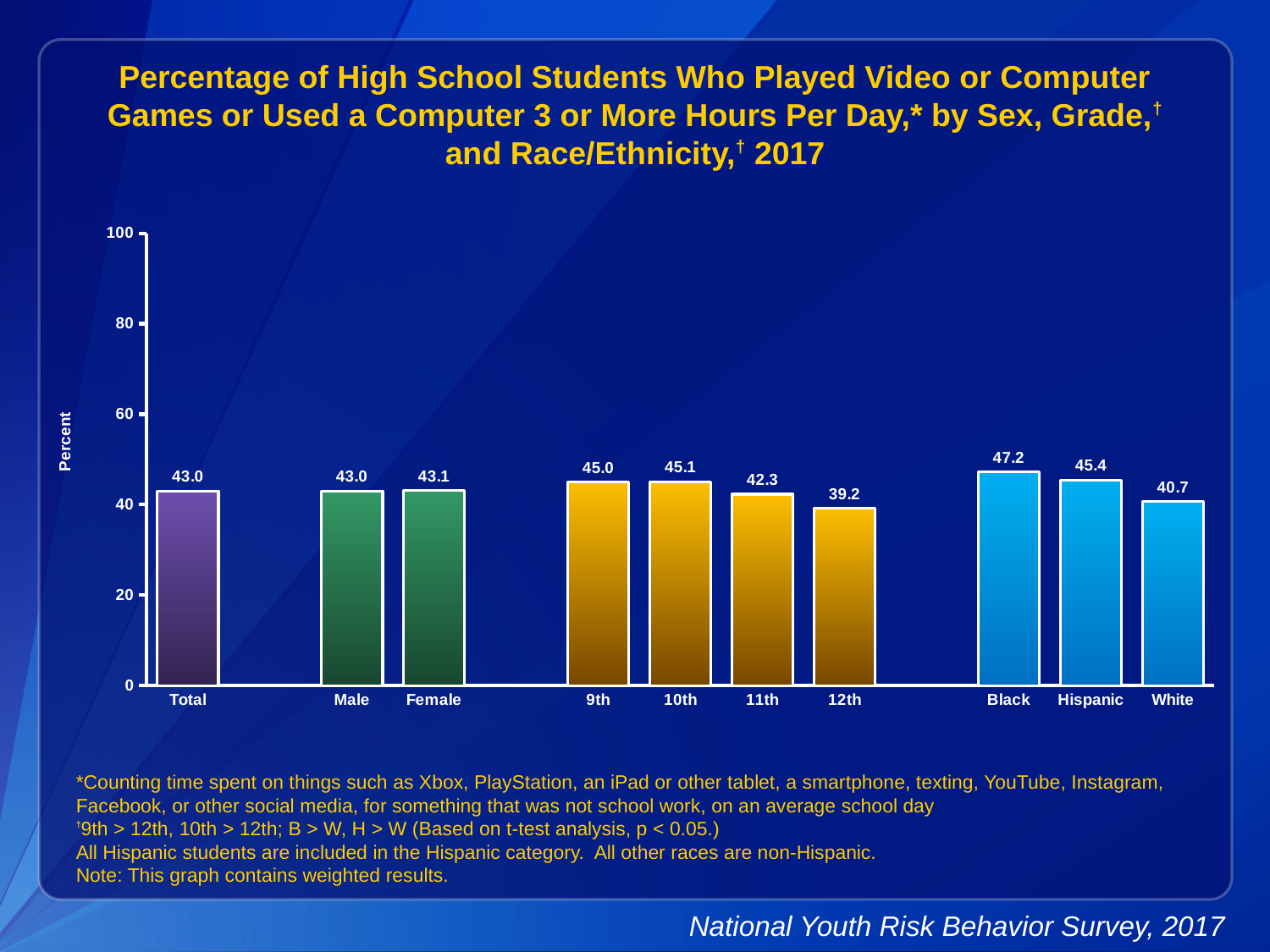
What is the value for Hispanic students? 45.4 What is the value for 12th grade? 39.2 How many bars are shown in the chart? 10 What is the value for Female? 43.1 Which category has the highest value? Black What is the difference between the values for Black and White? 6.5 What is the value for Total? 43.0 Which is larger, the value for 10th grade or the value for 11th grade? 10th Which category has the lowest value? 12th What is the difference between the values for 9th and 12th grade? 5.8 What kind of chart is shown on the slide? Bar chart What is the label of the y axis? Percent